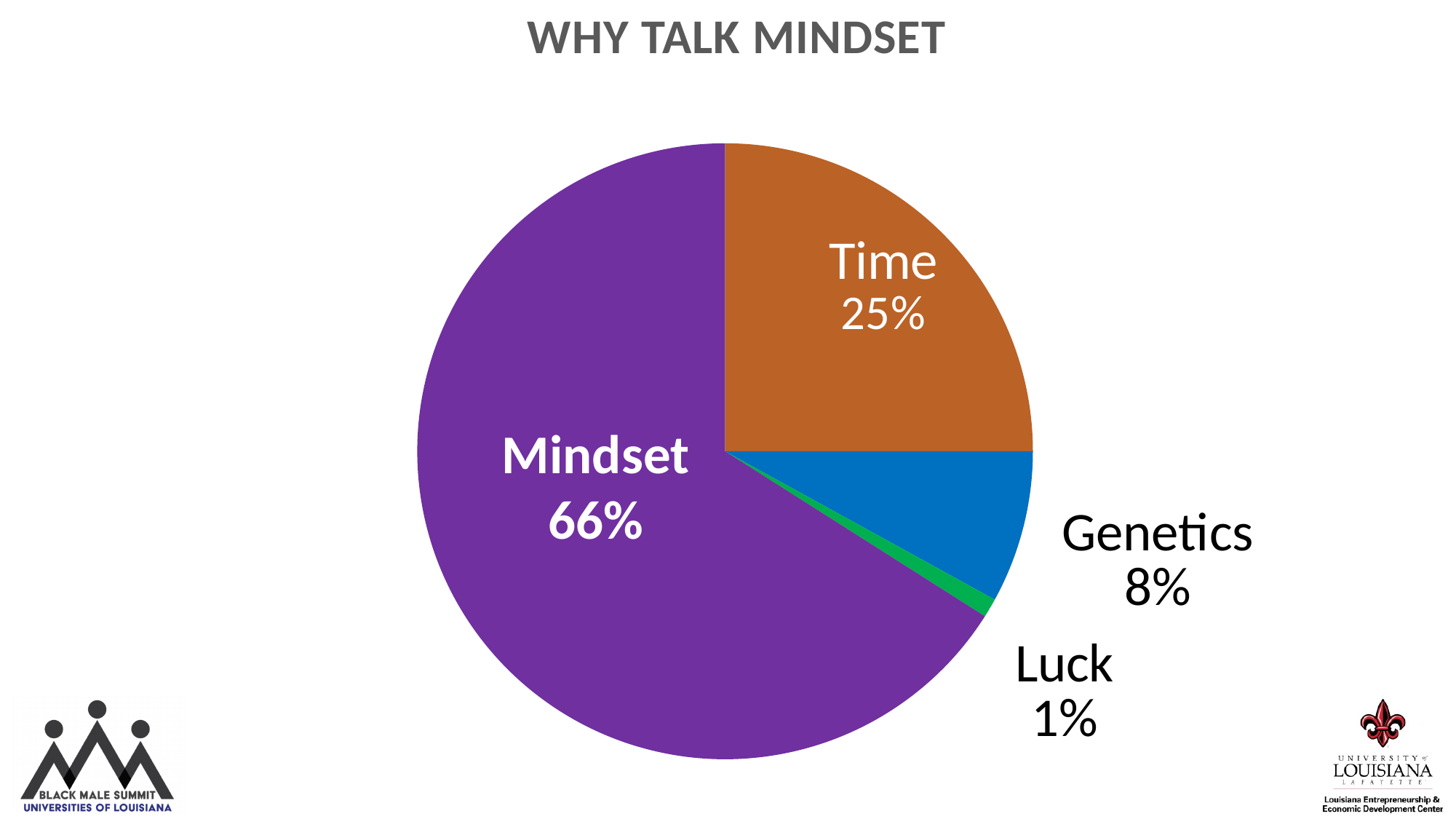
What is the title of the chart? WHY TALK MINDSET What is the difference in percentage points between Mindset and Time? 41 What percentage is shown for Genetics? 8% What percentage is shown for Luck? 1% Which slice of the pie is the largest? Mindset How many slices does the pie chart have? 4 What percentage is shown for Time? 25% Which is larger, Genetics or Time? Time What percentage is shown for Mindset? 66% What kind of chart is shown on the slide? pie chart What colour is the Mindset slice? purple Which slice of the pie is the smallest? Luck